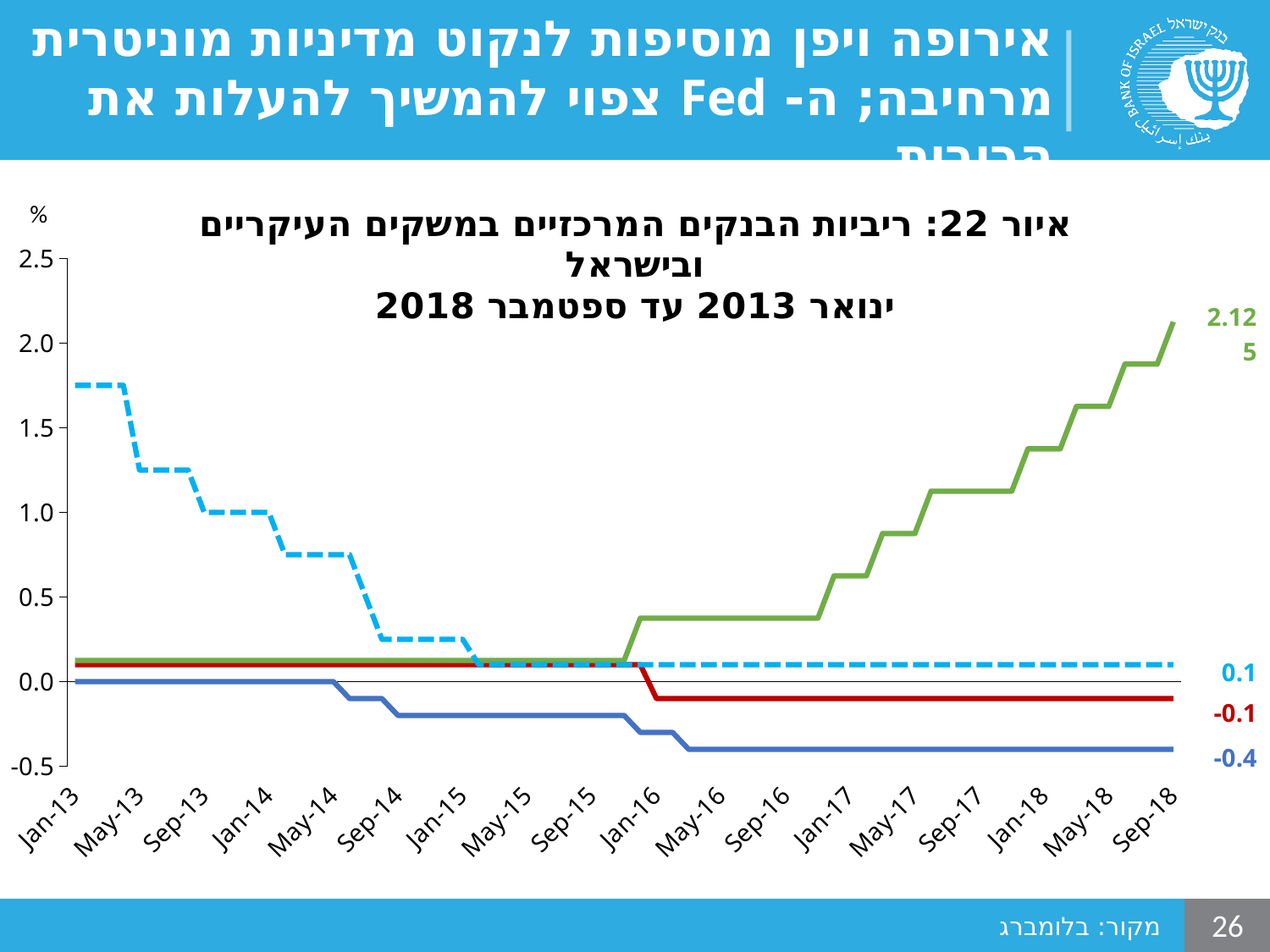
What is the value labelled at the end of the green line (Sep-18)? 2.125 What is the value labelled at the end of the dashed light-blue line? 0.1 Which line has the highest value at Sep-18? the green line Is the value of the dashed light-blue line at Jan-13 greater or less than 1.5? greater Which line has the lowest value at Sep-18? the dark-blue line What kind of chart is shown on the slide? line chart What unit is shown on the y axis of the chart? % What is the value labelled at the end of the red line? -0.1 What is the difference between the end values of the dashed light-blue line (0.1) and the dark-blue line (-0.4)? 0.5 What is the value labelled at the end of the dark-blue line? -0.4 How many lines are plotted on the chart? 4 Does the green line rise or fall between Jan-16 and Sep-18? rise